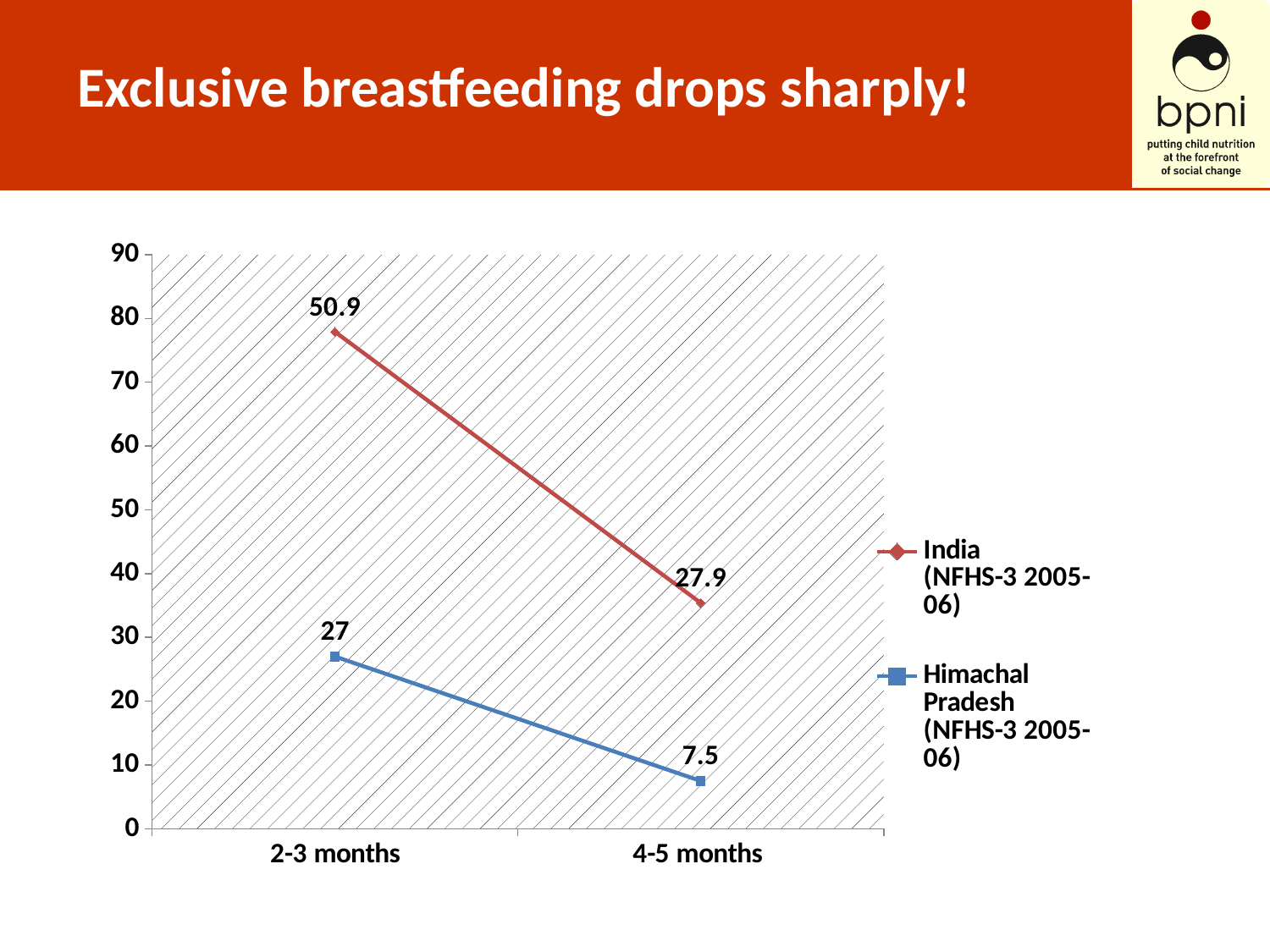
What is the value for Himachal Pradesh (NFHS-3 2005-06) at 4-5 months? 7.5 What is the value for Himachal Pradesh (NFHS-3 2005-06) at 2-3 months? 27 How many categories are shown on the x axis? 2 What is the difference between the Himachal Pradesh values at 2-3 months and 4-5 months? 19.5 What is the value for India (NFHS-3 2005-06) at 4-5 months? 27.9 What is the value for India (NFHS-3 2005-06) at 2-3 months? 50.9 Do the values for Himachal Pradesh rise or fall from 2-3 months to 4-5 months? fall What is the title of the slide? Exclusive breastfeeding drops sharply! What kind of chart is shown on the slide? line chart Which series has the higher value at 4-5 months, India or Himachal Pradesh? India What is the difference between the India values at 2-3 months and 4-5 months? 23 How many series does the legend list? 2